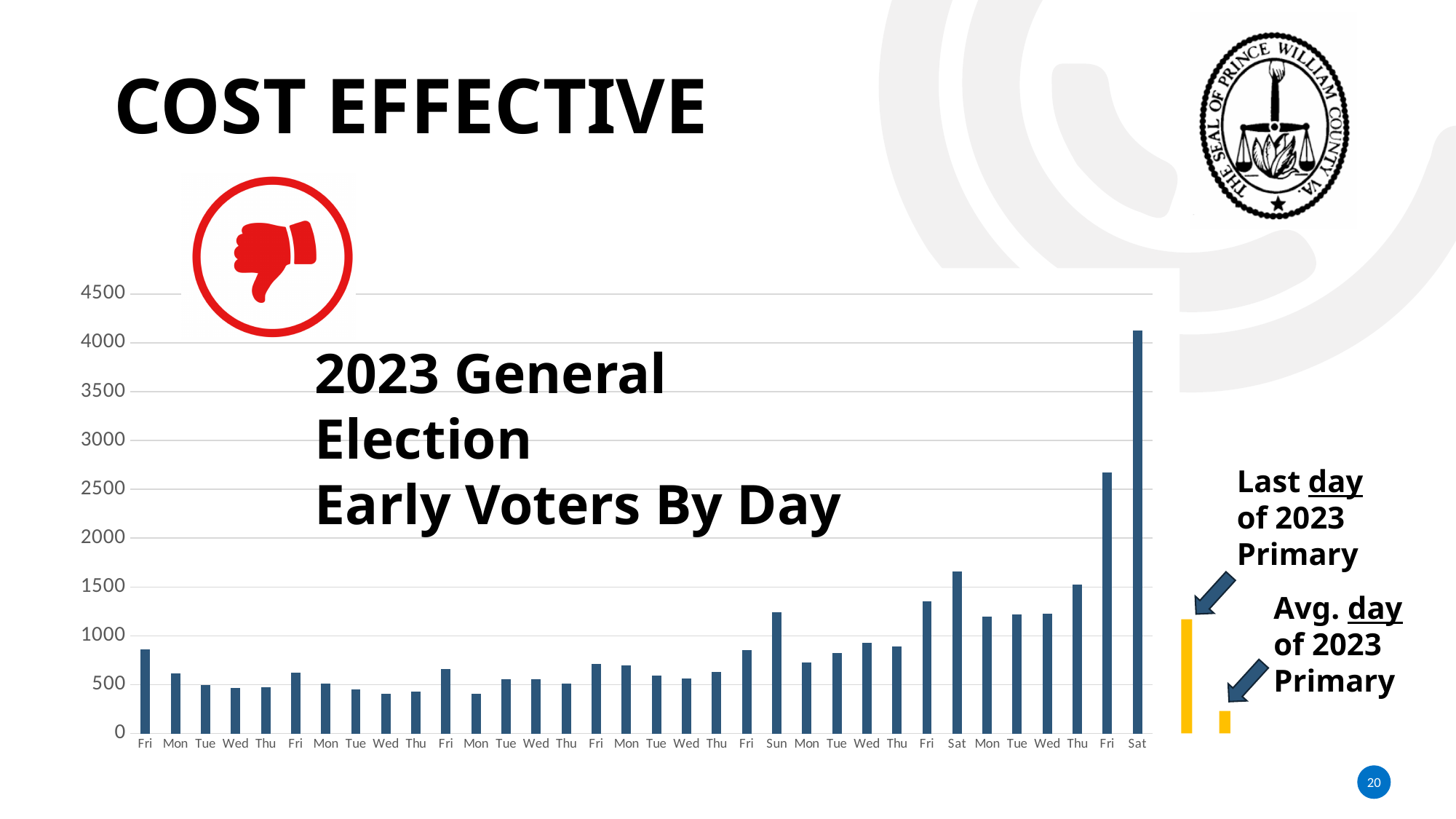
Is the value for the first Fri bar greater or less than 1000? less Which is larger, the final Sat bar or the final Fri bar? The final Sat bar Is the value for the Sun bar greater or less than 1000? greater How many day bars are plotted in the blue 2023 General Election series? 34 Is the value for the final Fri bar (second to last) greater or less than 2500? greater What kind of chart is shown on the slide? Bar chart What is the title of the chart? 2023 General Election Early Voters By Day What do the two yellow bars to the right of the chart represent? Last day of 2023 Primary and Avg. day of 2023 Primary Which is larger, the first Fri bar or the first Mon bar? The first Fri bar Overall, do the early voter counts rise or fall from left to right along the x axis? Rise Which day has the highest number of early voters in the chart? The final Sat